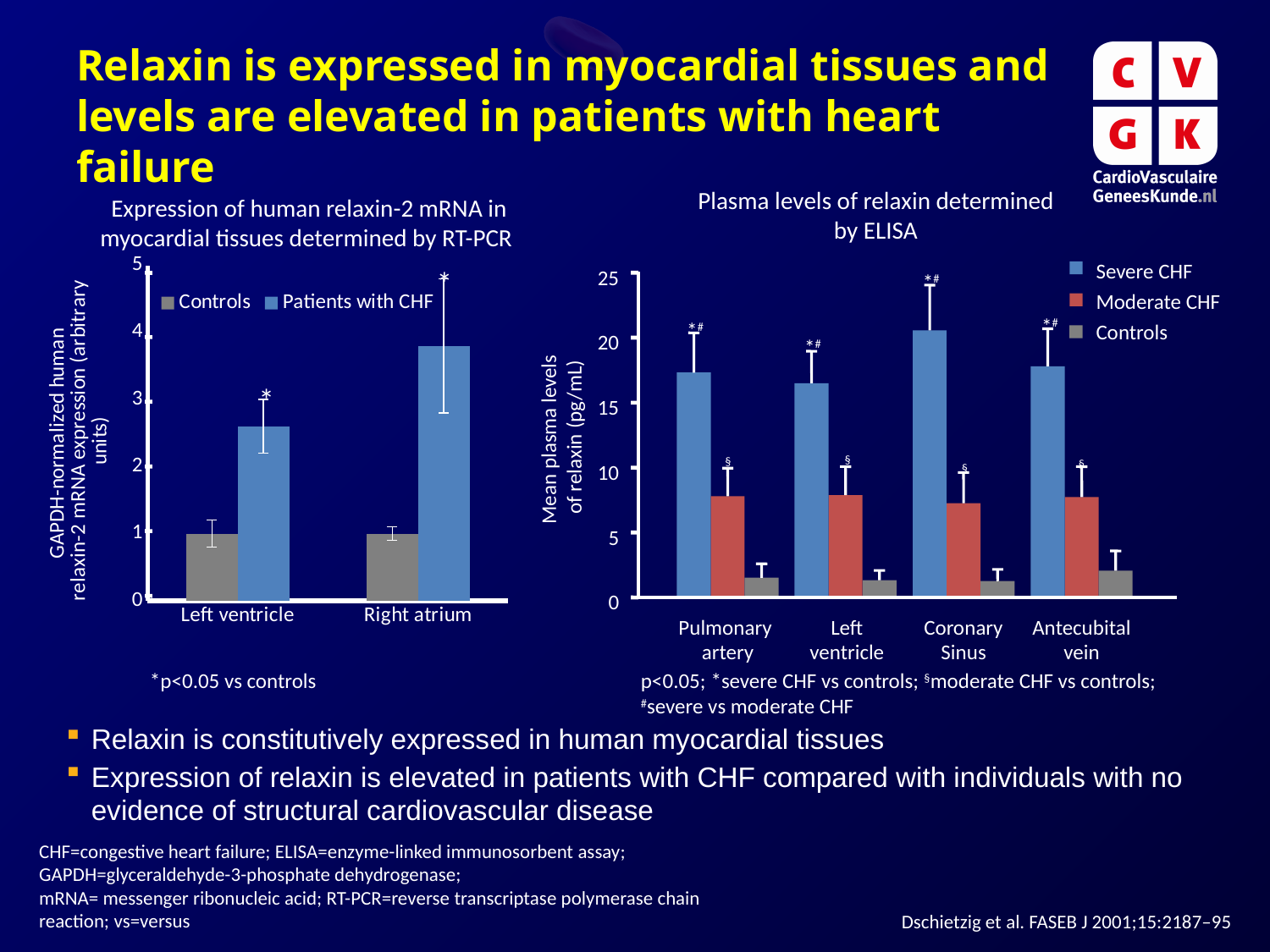
What type of chart is the left chart, 'Expression of human relaxin-2 mRNA in myocardial tissues determined by RT-PCR'? Bar chart In the left chart (RT-PCR), is the value for Controls in the Left ventricle greater or less than 2? less In the right chart (ELISA), is the Severe CHF value for Pulmonary artery greater or less than 15? greater What is the y-axis label of the right chart, 'Plasma levels of relaxin determined by ELISA'? Mean plasma levels of relaxin (pg/mL) In the left chart (RT-PCR), which is larger for Patients with CHF: Left ventricle or Right atrium? Right atrium In the right chart (ELISA), is the Controls value for Antecubital vein greater or less than 5? less How many series does the legend of the right chart, 'Plasma levels of relaxin determined by ELISA', list? 3 In the right chart (ELISA), which category has the highest Severe CHF value? Coronary Sinus In the right chart (ELISA), which is larger for Coronary Sinus: Severe CHF or Moderate CHF? Severe CHF How many categories are shown on the x axis of the right chart, 'Plasma levels of relaxin determined by ELISA'? 4